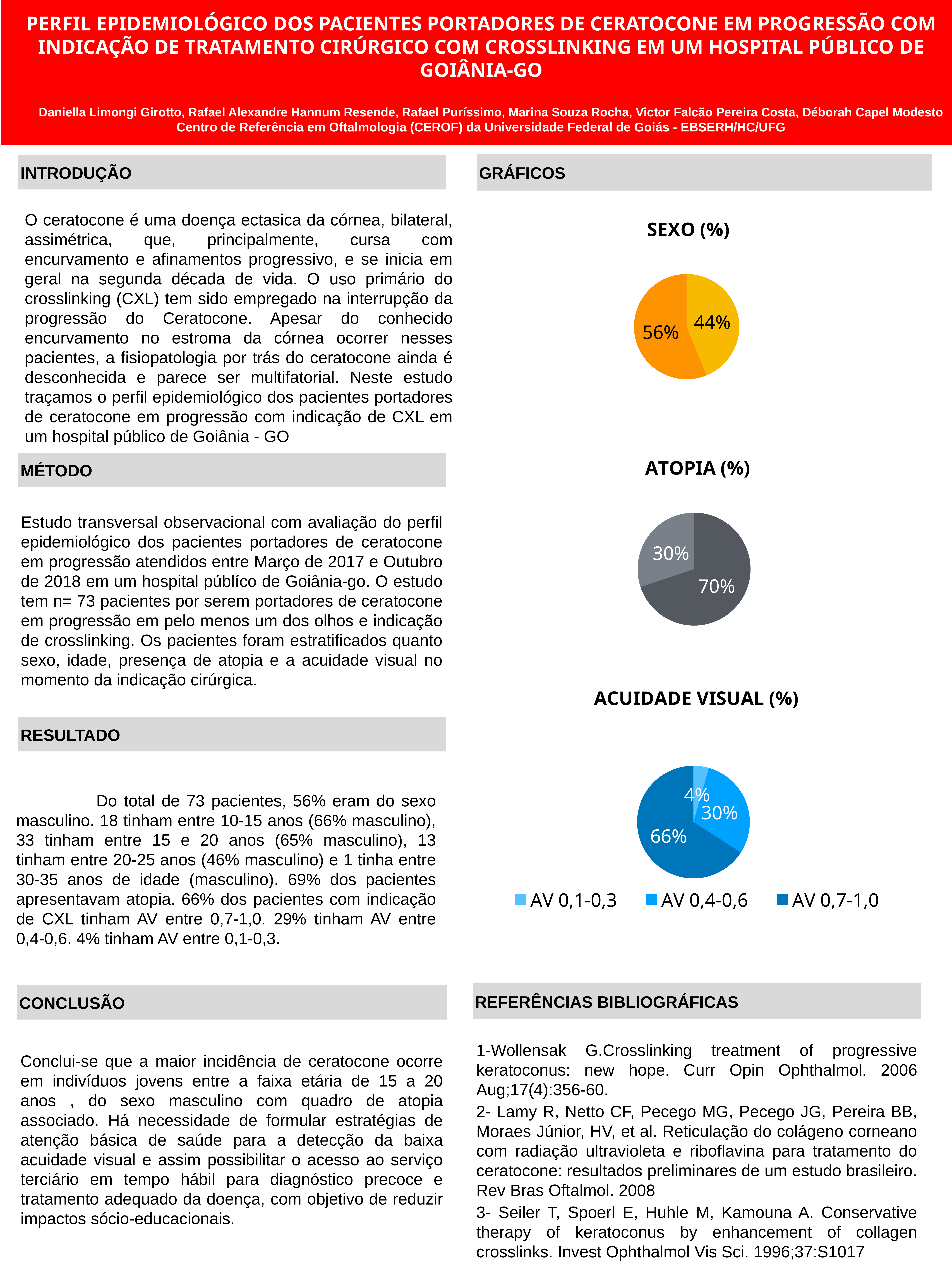
In the "ACUIDADE VISUAL (%)" chart, what is the value for AV 0,4-0,6? 30% How many slices does the "ATOPIA (%)" chart have? 2 In the "ATOPIA (%)" chart, what is the value of the largest slice? 70% In the "SEXO (%)" chart, what is the value of the smallest slice? 44% How many categories does the legend of the "ACUIDADE VISUAL (%)" chart list? 3 In the "SEXO (%)" chart, what is the difference between the two slices? 12% In the "ACUIDADE VISUAL (%)" chart, which category has the smallest share? AV 0,1-0,3 In the "ATOPIA (%)" chart, what is the difference between the larger and smaller slice? 40% What kind of chart is the "SEXO (%)" chart? pie chart In the "ACUIDADE VISUAL (%)" chart, what is the value for AV 0,7-1,0? 66% In the "SEXO (%)" chart, what is the value of the largest slice? 56% In the "ACUIDADE VISUAL (%)" chart, which is larger, AV 0,4-0,6 or AV 0,1-0,3? AV 0,4-0,6